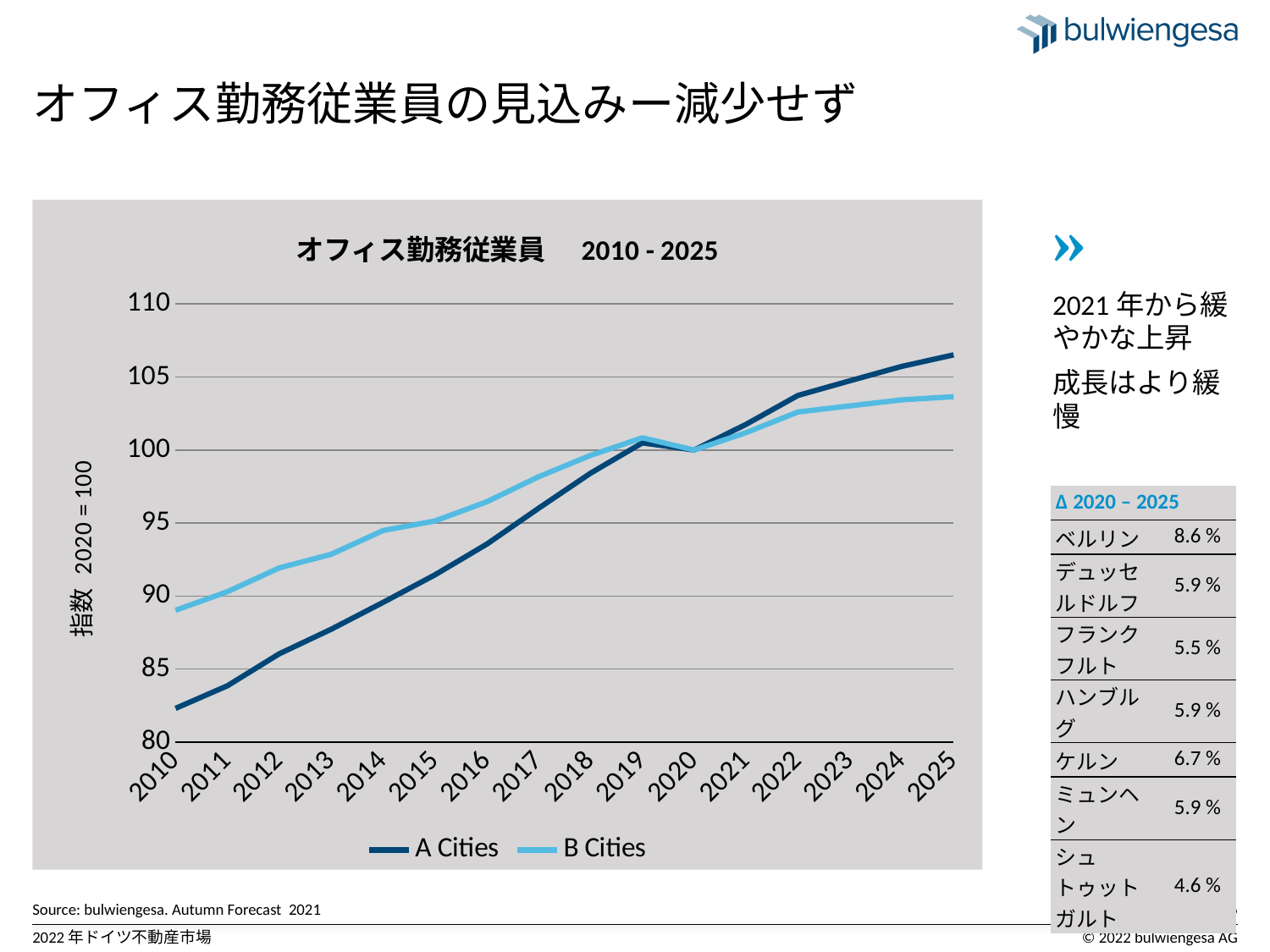
Is the value for A Cities in 2010 greater or less than 85? less In 2010, which series has the higher value, A Cities or B Cities? B Cities Is the value for B Cities in 2025 greater or less than 105? less In 2025, which series has the higher value, A Cities or B Cities? A Cities Is the value for A Cities in 2025 greater or less than 105? greater What kind of chart is shown on the slide? line chart Do the values for A Cities generally rise or fall from 2010 to 2025? rise How many series does the chart legend list? 2 What is the index value for A Cities in 2020? 100 What is the index value for B Cities in 2020? 100 How many years are plotted along the x axis of the chart? 16